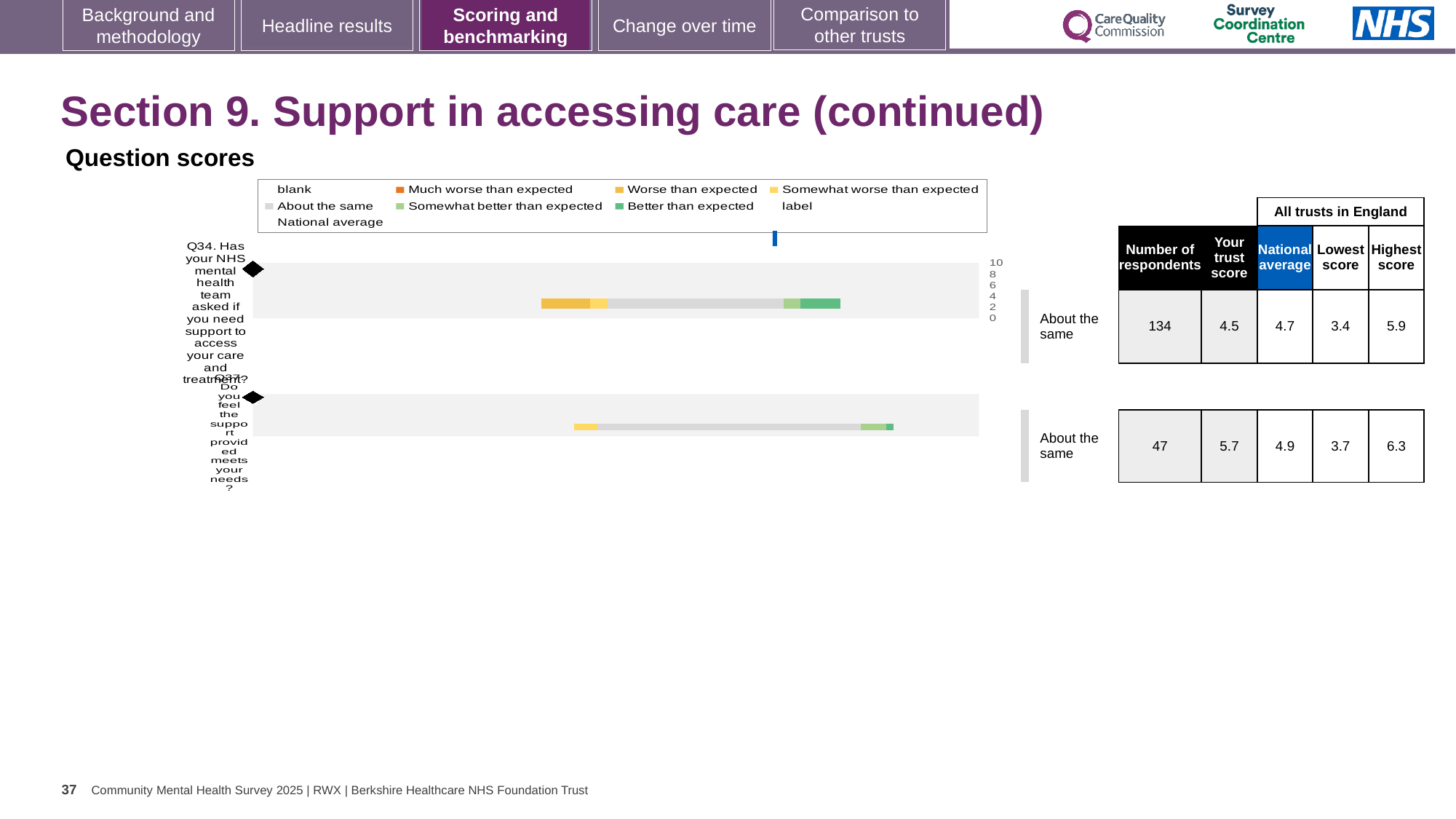
How many respondents answered Q37 according to the table next to the chart? 47 What is the trust score for Q37 shown in the table next to the chart? 5.7 What benchmark category is shown beside the bar for Q34? About the same How many survey questions are plotted in the question scores chart? 2 What is the national average for Q34 in the table next to the chart? 4.7 Which question has the higher trust score, Q34 or Q37? Q37 Which legend entry is shown in dark green in the question scores chart? Better than expected What is the lowest score across all trusts in England for Q34? 3.4 What is the highest score across all trusts in England for Q37? 6.3 What is the trust score for Q34 shown in the table next to the chart? 4.5 What kind of chart is used to show the question scores on this slide? bar chart What is the difference between the trust scores for Q37 and Q34? 1.2